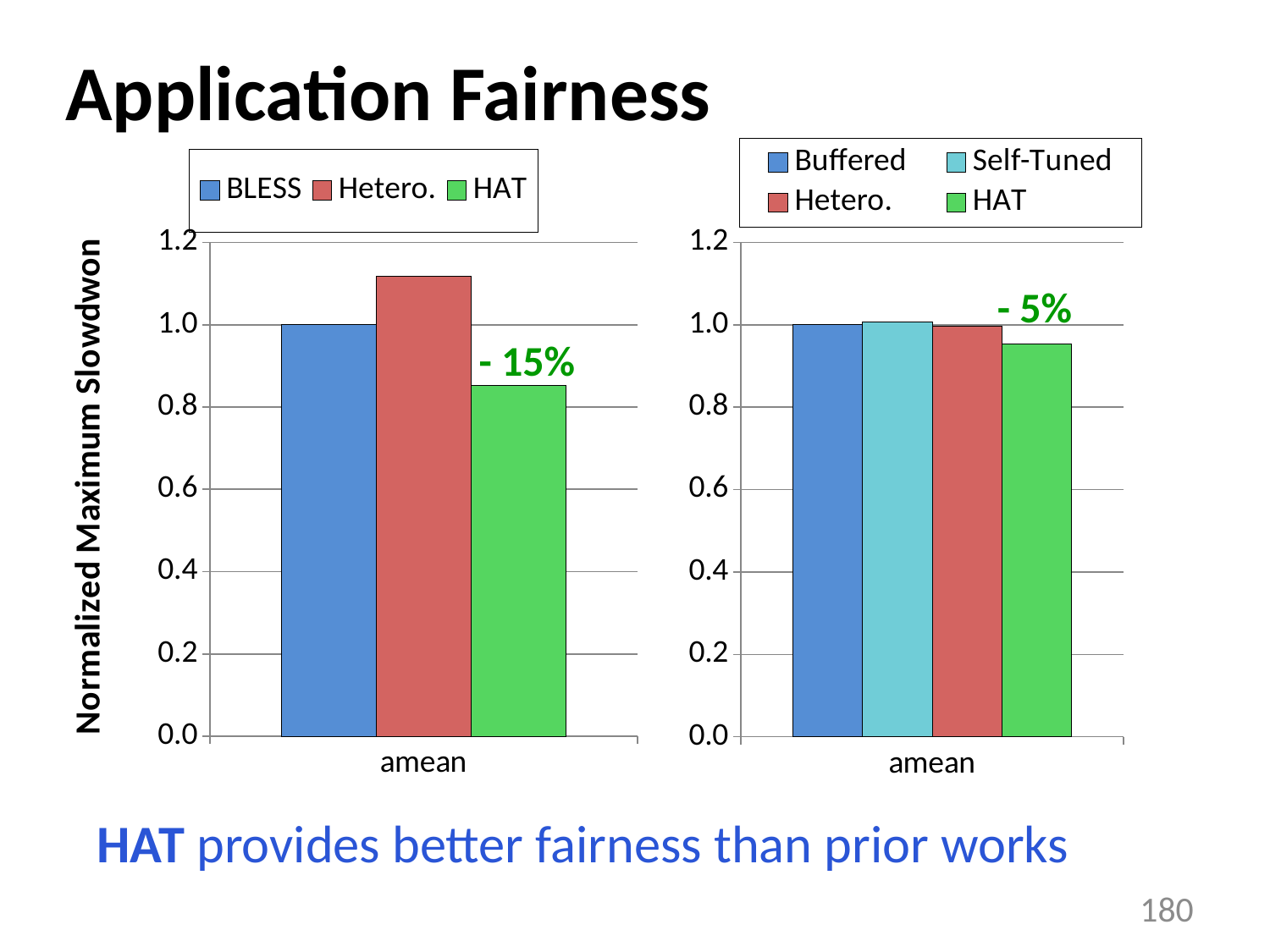
What kind of chart is the left chart? bar chart In the left chart, is the value for Hetero. greater or less than 1.0? greater How many series does the legend of the right chart list? 4 In the left chart, which series has the highest normalized maximum slowdown? Hetero. What percentage annotation is printed next to the HAT bar in the left chart? - 15% How many categories are shown on the x axis of the left chart? 1 In the left chart, is the value for HAT greater or less than 1.0? less How many series does the legend of the left chart list? 3 In the right chart, is the value for HAT greater or less than 1.0? less In the right chart, which series has the lowest normalized maximum slowdown? HAT In the left chart, which is larger, the value for BLESS or the value for HAT? BLESS In the left chart, which series has the lowest normalized maximum slowdown? HAT